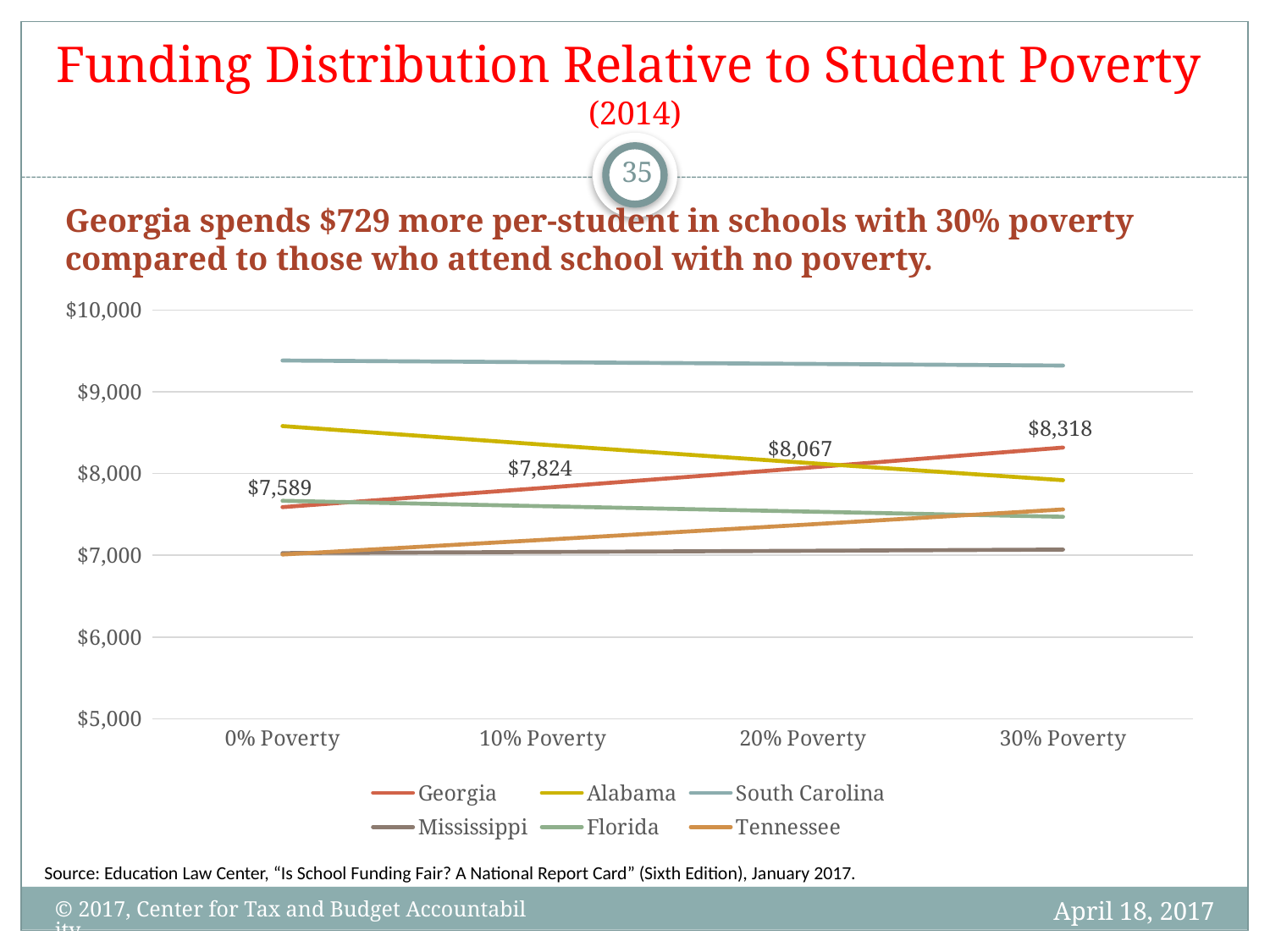
What is the value for Georgia at 20% Poverty? $8,067 What is the difference between Georgia's value at 30% Poverty and at 0% Poverty? $729 Which series has the highest value at 0% Poverty? South Carolina What is the value for Georgia at 0% Poverty? $7,589 At 30% Poverty, which is larger: Georgia or Alabama? Georgia Is the value for Alabama at 0% Poverty greater or less than $8,000? greater Which series has the lowest value at 30% Poverty? Mississippi Does the Alabama line rise or fall from 0% Poverty to 30% Poverty? fall What is the difference between Georgia's value at 10% Poverty and at 0% Poverty? $235 How many series does the legend list? 6 What is the value for Georgia at 30% Poverty? $8,318 Is the value for Florida at 30% Poverty greater or less than $8,000? less